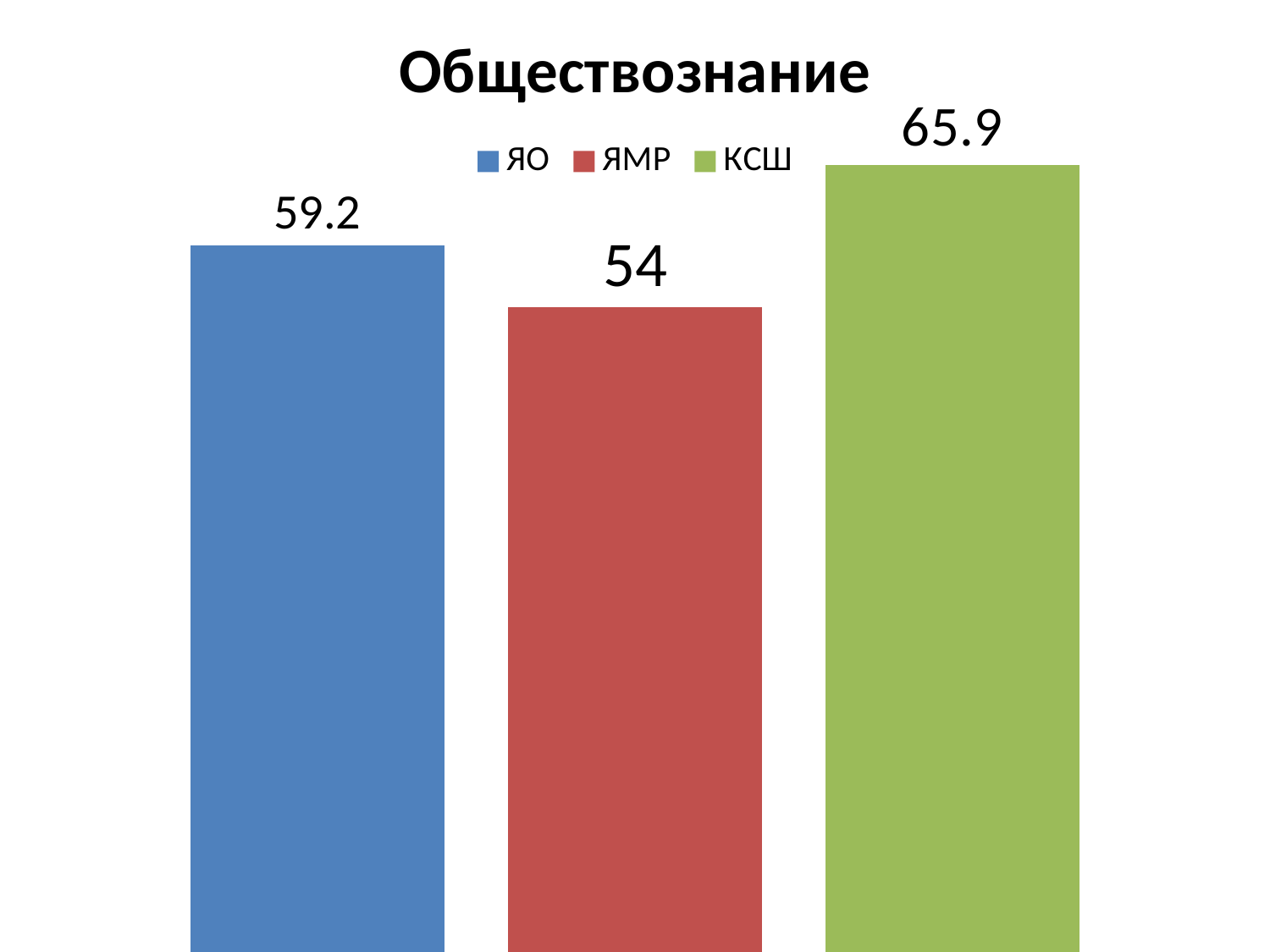
What is the title of the chart? Обществознание What kind of chart is shown? bar chart What is the value for ЯО? 59.2 Which series has the lowest value? ЯМР How many series does the legend list? 3 Which series has the highest value? КСШ What is the value for КСШ? 65.9 What is the value for ЯМР? 54 How many bars are shown in the chart? 3 What is the difference between the values for КСШ and ЯО? 6.7 What is the difference between the values for ЯО and ЯМР? 5.2 Which is larger, the value for ЯО or the value for ЯМР? ЯО